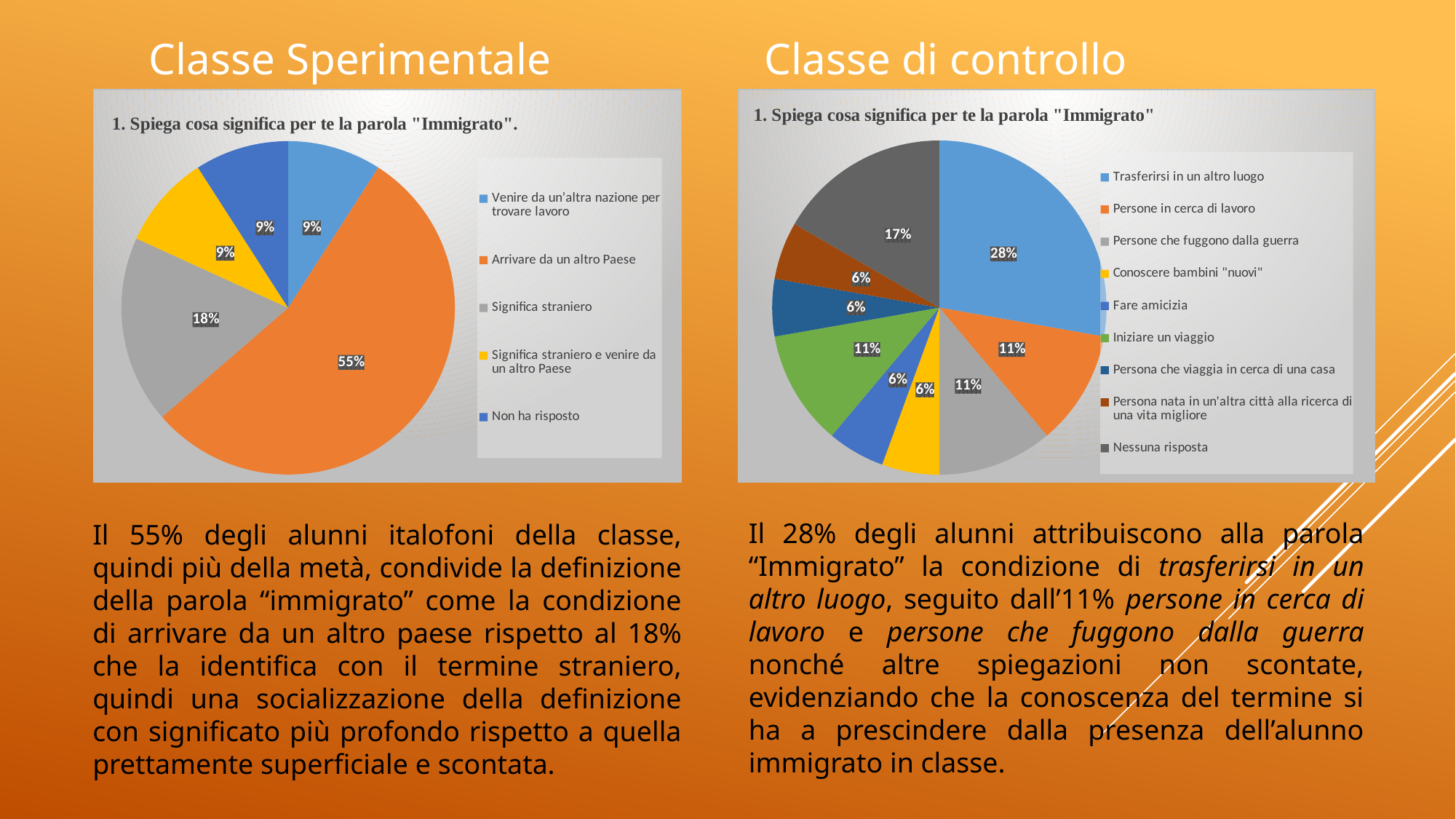
In the Classe Sperimentale chart, what share of the pie is 'Arrivare da un altro Paese'? 55% In the Classe di controllo chart, how many categories does the legend list? 9 In the Classe di controllo chart, which category has the largest slice? Trasferirsi in un altro luogo In the Classe Sperimentale chart, what is the difference between 'Arrivare da un altro Paese' and 'Significa straniero'? 37% In the Classe Sperimentale chart, what percentage is shown for 'Significa straniero'? 18% In the Classe Sperimentale chart, how many categories does the legend list? 5 In the Classe di controllo chart, which is larger: 'Nessuna risposta' or 'Iniziare un viaggio'? Nessuna risposta In the Classe di controllo chart, what percentage is shown for 'Trasferirsi in un altro luogo'? 28% In the Classe di controllo chart, what percentage is shown for 'Nessuna risposta'? 17% What kind of chart is shown under Classe di controllo? Pie chart In the Classe Sperimentale chart, which category has the largest slice? Arrivare da un altro Paese What is the title of the Classe di controllo chart? 1. Spiega cosa significa per te la parola "Immigrato"